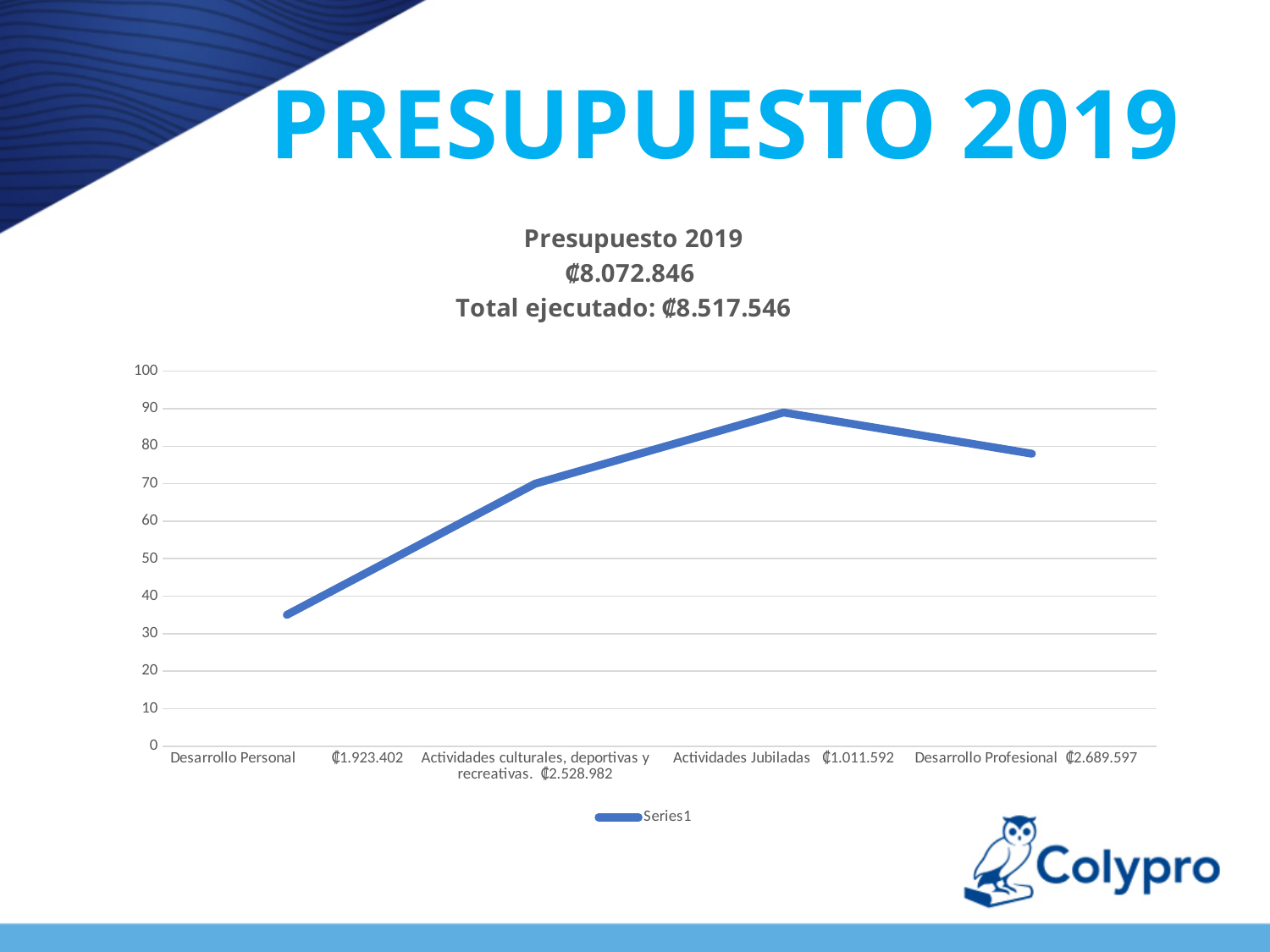
What kind of chart is shown on the slide? line chart What total executed amount (Total ejecutado) is stated in the chart title? ₡8.517.546 Is the value for Actividades culturales, deportivas y recreativas greater or less than 60? greater Does the line rise or fall between Actividades Jubiladas and Desarrollo Profesional? falls Which category has the lowest value on the line? Desarrollo Personal Is the value for Desarrollo Personal greater or less than 40? less What is the name of the series shown in the chart's legend? Series1 Which is larger, the value for Desarrollo Personal or the value for Desarrollo Profesional? Desarrollo Profesional How many categories are plotted along the x axis of the chart? 4 Is the value for Actividades Jubiladas greater or less than 80? greater Which category has the highest value on the line? Actividades Jubiladas How many series does the chart's legend list? 1